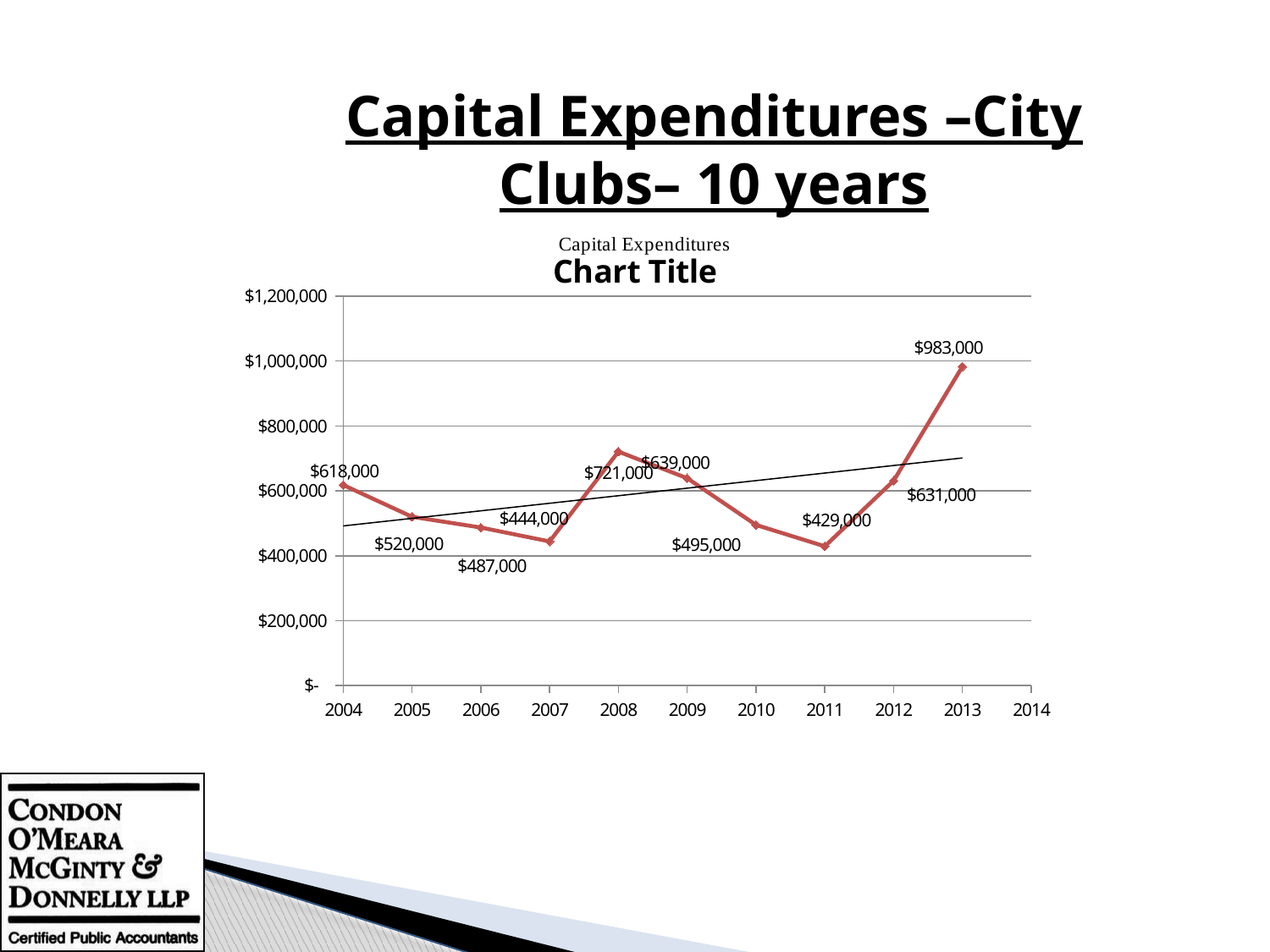
How many years have a plotted data point on the chart? 10 What is the difference between the capital expenditure in 2008 and in 2007? $277,000 Which year has the lowest capital expenditure? 2011 Is the capital expenditure for 2010 greater or less than $600,000? less What is the capital expenditure value for 2013? $983,000 What is the capital expenditure value for 2007? $444,000 Which year has the larger capital expenditure, 2004 or 2009? 2009 Do the capital expenditure values rise or fall from 2011 to 2013? rise What kind of chart is shown on the slide? line chart What is the difference between the capital expenditure in 2013 and in 2012? $352,000 Which year has the highest capital expenditure? 2013 What is the capital expenditure value for 2008? $721,000